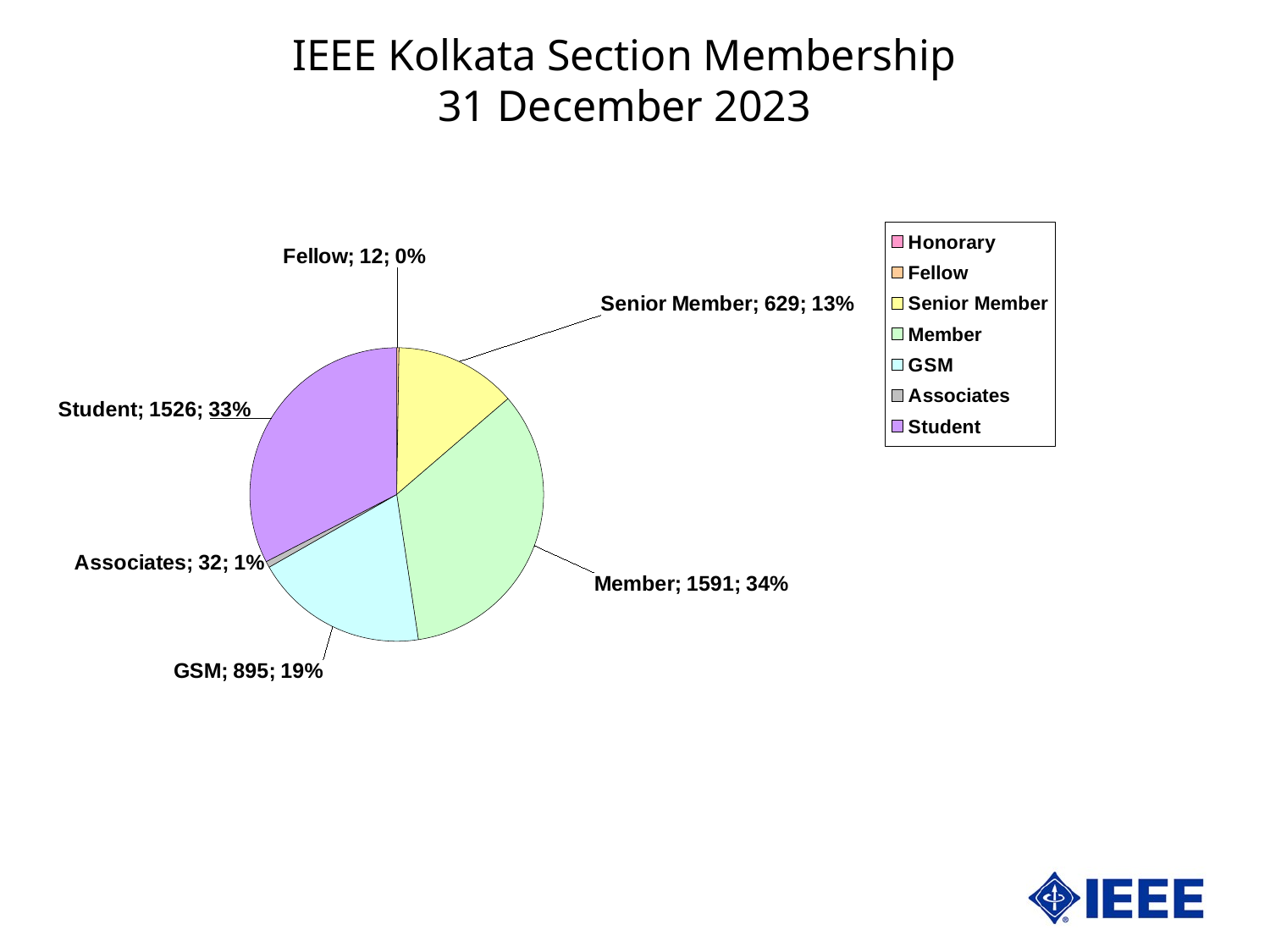
Which is larger, the GSM count or the Senior Member count? GSM What is the difference between the Member count and the Student count? 65 What is the membership count for Fellow? 12 What is the membership count for Associates? 32 How many categories does the legend list? 7 What share of the pie does the Member category represent? 34% Which category has the largest membership count? Member What share of the pie does the Student category represent? 33% What type of chart is shown on the slide? Pie chart What is the membership count for GSM? 895 What is the title of the chart? IEEE Kolkata Section Membership 31 December 2023 What is the membership count for Senior Member? 629